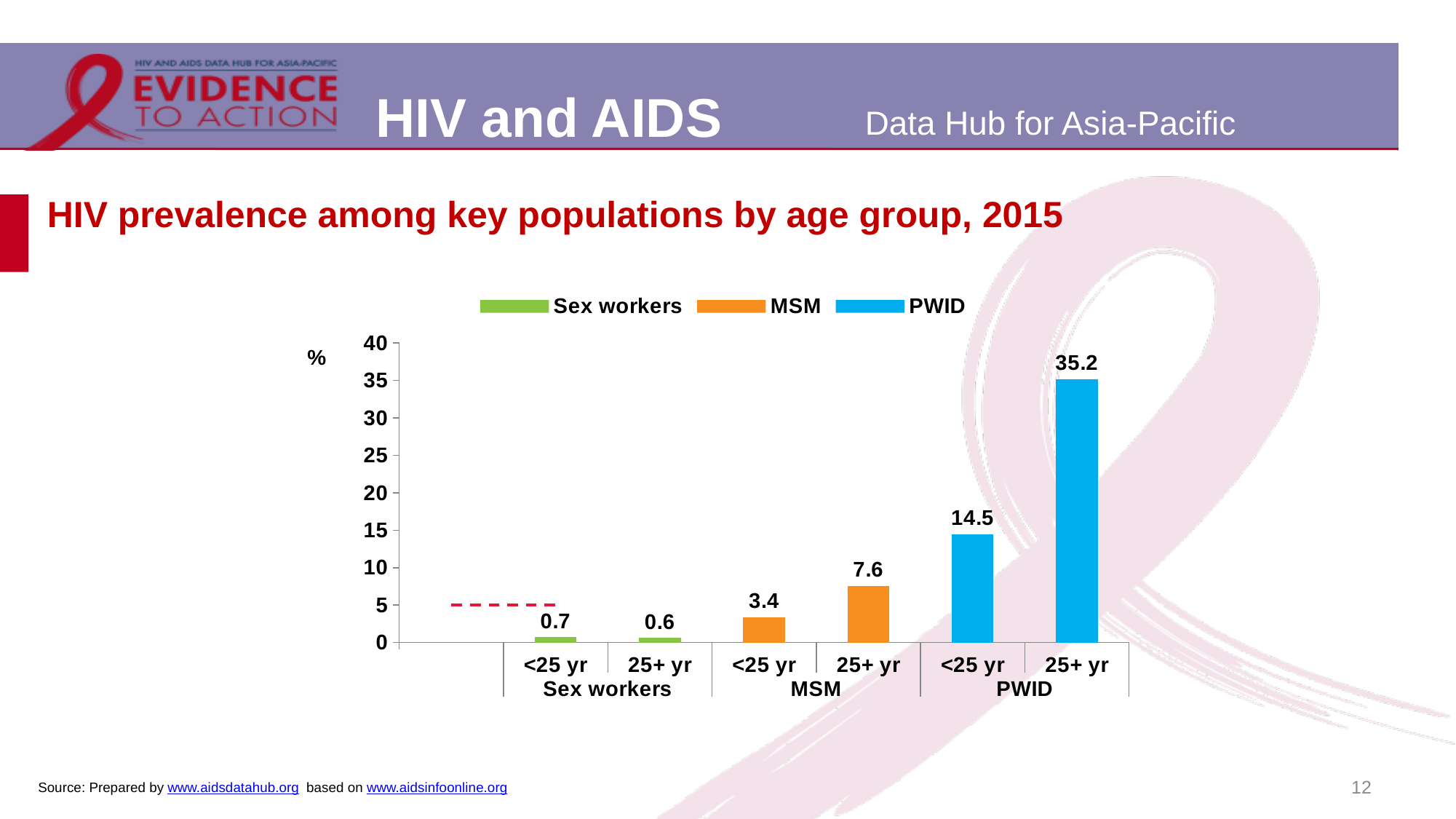
Which bar has the highest HIV prevalence? PWID 25+ yr What colour represents PWID in the chart? Blue Which is larger: HIV prevalence among MSM aged 25+ yr or PWID aged <25 yr? PWID <25 yr What kind of chart is shown on the slide? Bar chart How many bars are plotted in the chart? 6 What is the HIV prevalence among PWID aged 25+ yr? 35.2 Which bar has the lowest HIV prevalence? Sex workers 25+ yr What is the difference in HIV prevalence between PWID aged 25+ yr and PWID aged <25 yr? 20.7 What is the HIV prevalence among MSM aged 25+ yr? 7.6 How many series does the legend list? 3 What is the HIV prevalence among sex workers aged <25 yr? 0.7 What is the difference in HIV prevalence between MSM aged 25+ yr and MSM aged <25 yr? 4.2